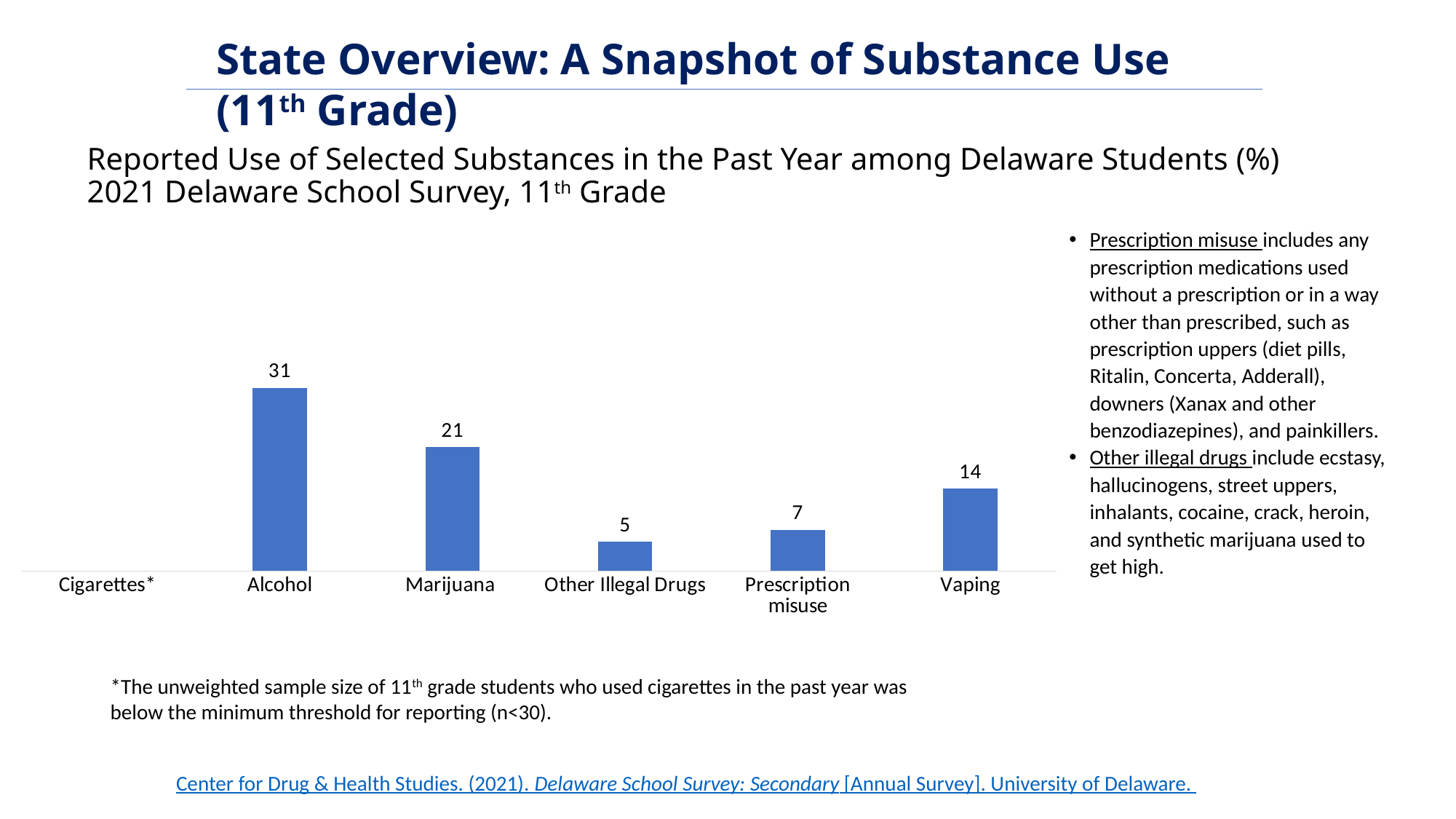
What kind of chart is shown on the slide? Bar chart What is the value for Prescription misuse? 7 Which is larger, the value for Vaping or the value for Prescription misuse? Vaping Among the substances with a plotted bar, which has the lowest reported use? Other Illegal Drugs Which substance has the highest reported use? Alcohol What is the value for Alcohol? 31 What is the value for Marijuana? 21 What is the difference between the values for Alcohol and Marijuana? 10 What is the difference between the values for Vaping and Other Illegal Drugs? 9 What is the value for Vaping? 14 Why is there no bar shown for Cigarettes? The sample size was below the minimum threshold for reporting (n<30) How many categories are shown on the x axis of the chart? 6